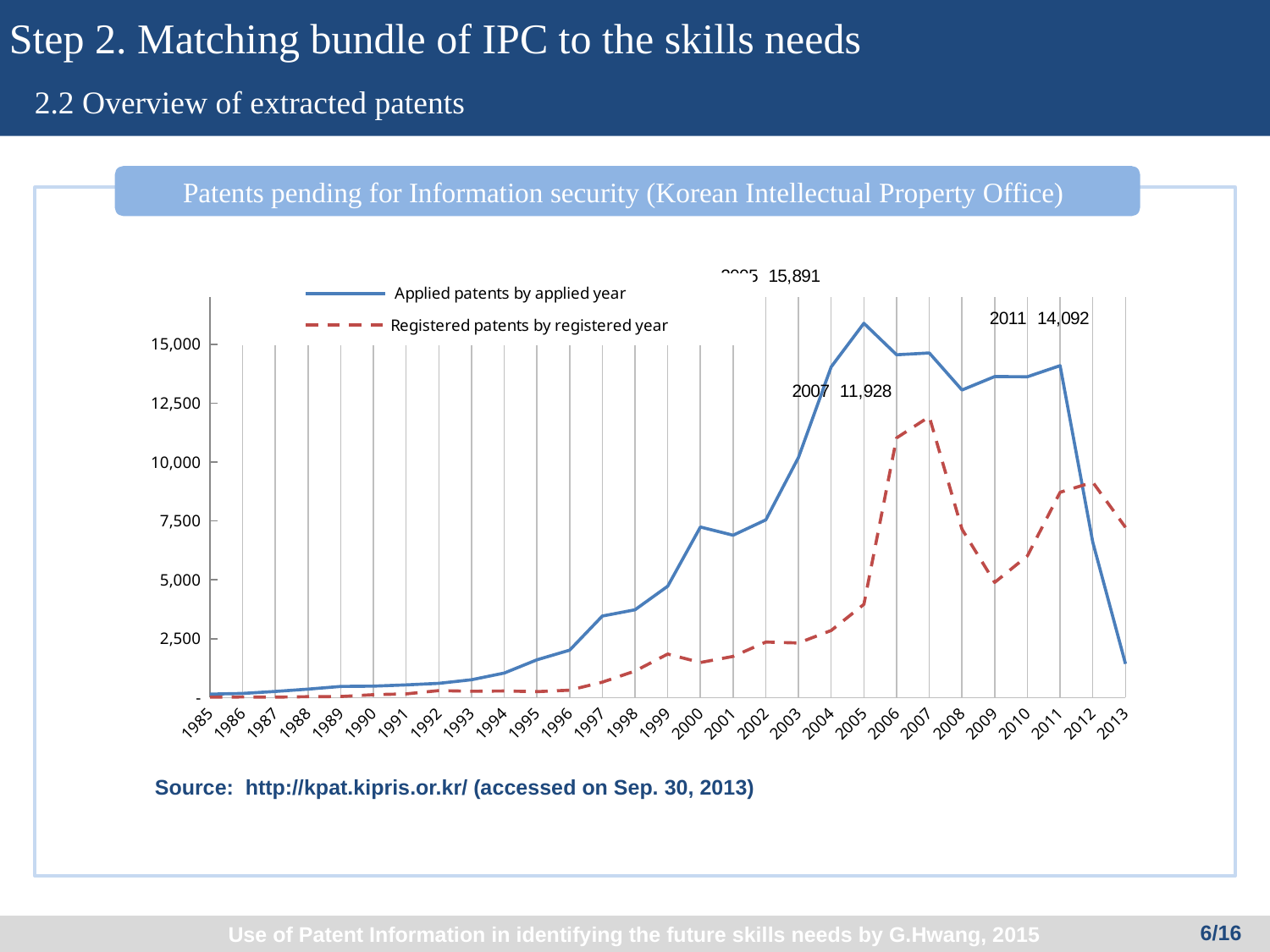
How many years are shown along the x axis? 29 What is the number of registered patents in 2007? 11,928 How many series does the legend list? 2 In which year do applied patents reach their highest value? 2005 What is the number of applied patents in 2005? 15,891 What is the number of applied patents in 2011? 14,092 What kind of chart is shown on the slide? line chart What is the title of the chart? Patents pending for Information security (Korean Intellectual Property Office) Is the value for applied patents in 2013 greater or less than 2,500? less Is the value for applied patents in 2008 greater or less than 12,500? greater What is the difference between the applied patents in 2005 and in 2011? 1,799 In which year do registered patents reach their highest value? 2007